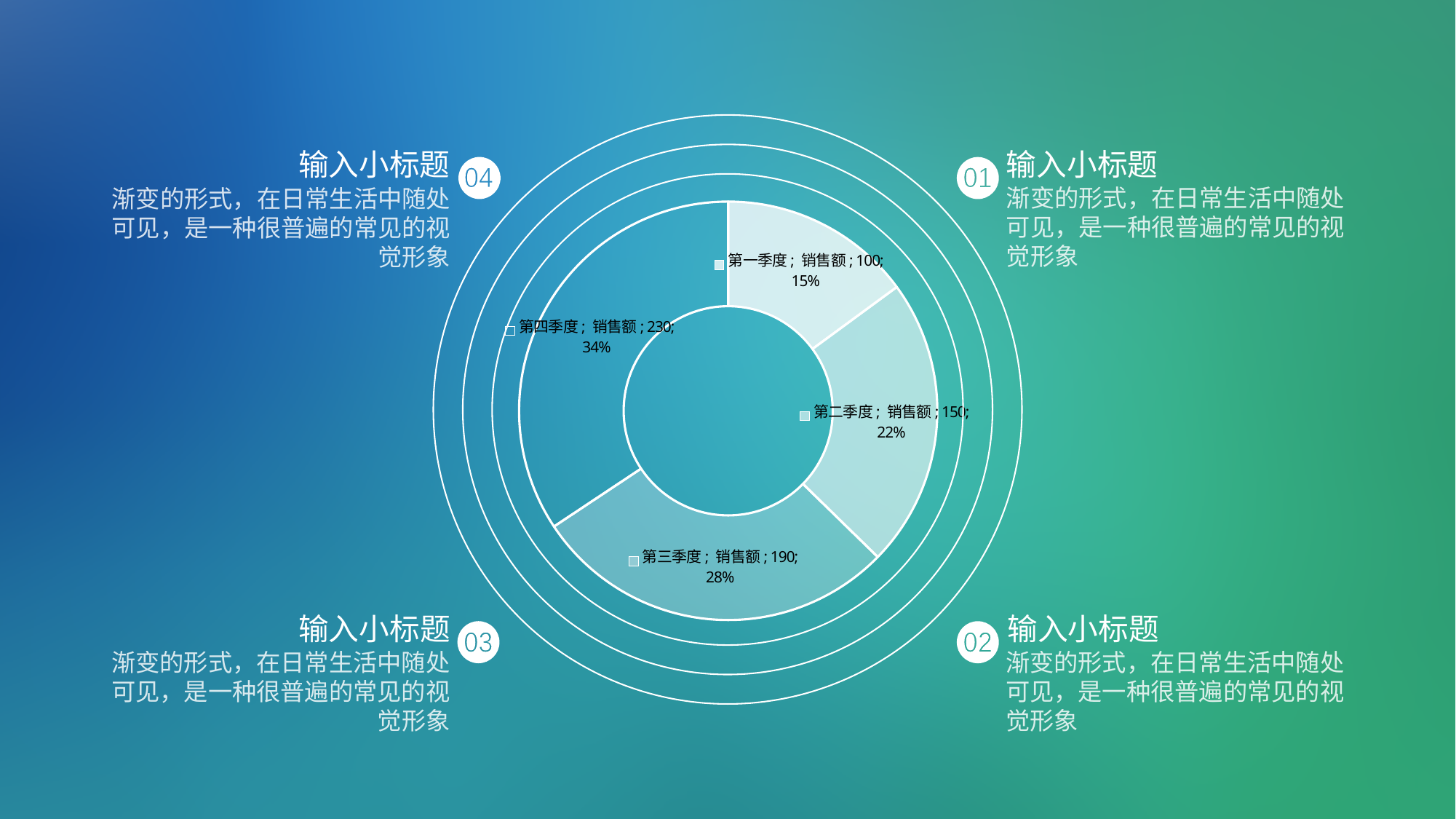
Which quarter has the lowest 销售额? 第一季度 Which quarter has the highest 销售额? 第四季度 How many categories are shown in the doughnut chart? 4 What is the 销售额 value for 第四季度? 230 What share of the doughnut does 第三季度 represent? 28% What is the 销售额 value for 第一季度? 100 What is the 销售额 value for 第二季度? 150 What is the difference in 销售额 between 第四季度 and 第一季度? 130 What type of chart is shown on the slide? Doughnut chart Which has a larger 销售额, 第二季度 or 第三季度? 第三季度 What is the name of the data series shown in the chart's data labels? 销售额 What is the 销售额 value for 第三季度? 190